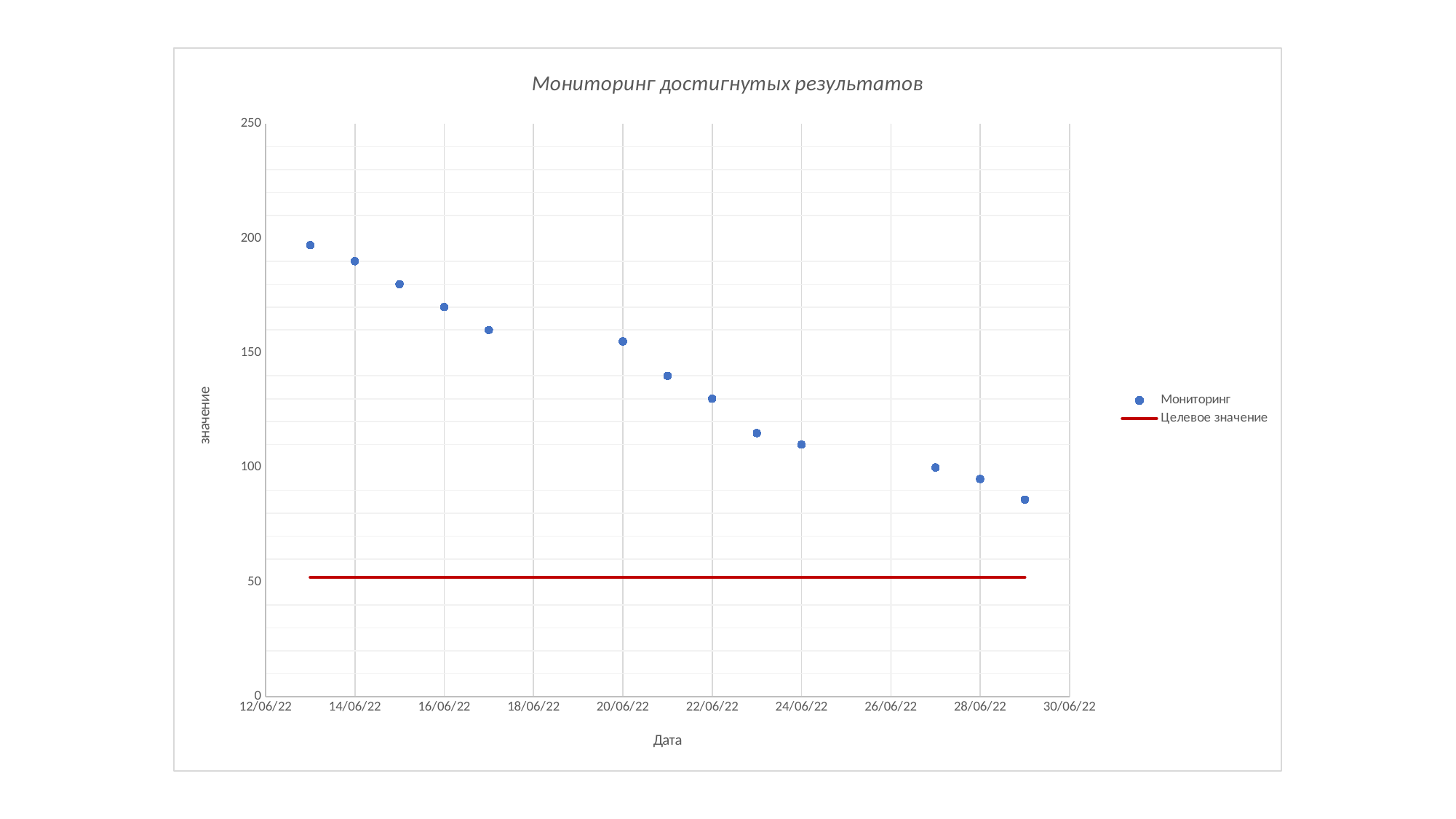
Is the Мониторинг value on 14/06/22 greater or less than 150? greater Is the Целевое значение line greater or less than 100? less Is the Мониторинг value on 22/06/22 greater or less than 150? less Do the Мониторинг values rise or fall over time along the x axis? fall What is the title of the chart? Мониторинг достигнутых результатов Which series is drawn as a red line? Целевое значение What kind of chart is shown on the slide? scatter chart Which is larger, the Мониторинг value on 16/06/22 or on 24/06/22? 16/06/22 How many series does the legend list? 2 How many data points are plotted for the Мониторинг series? 13